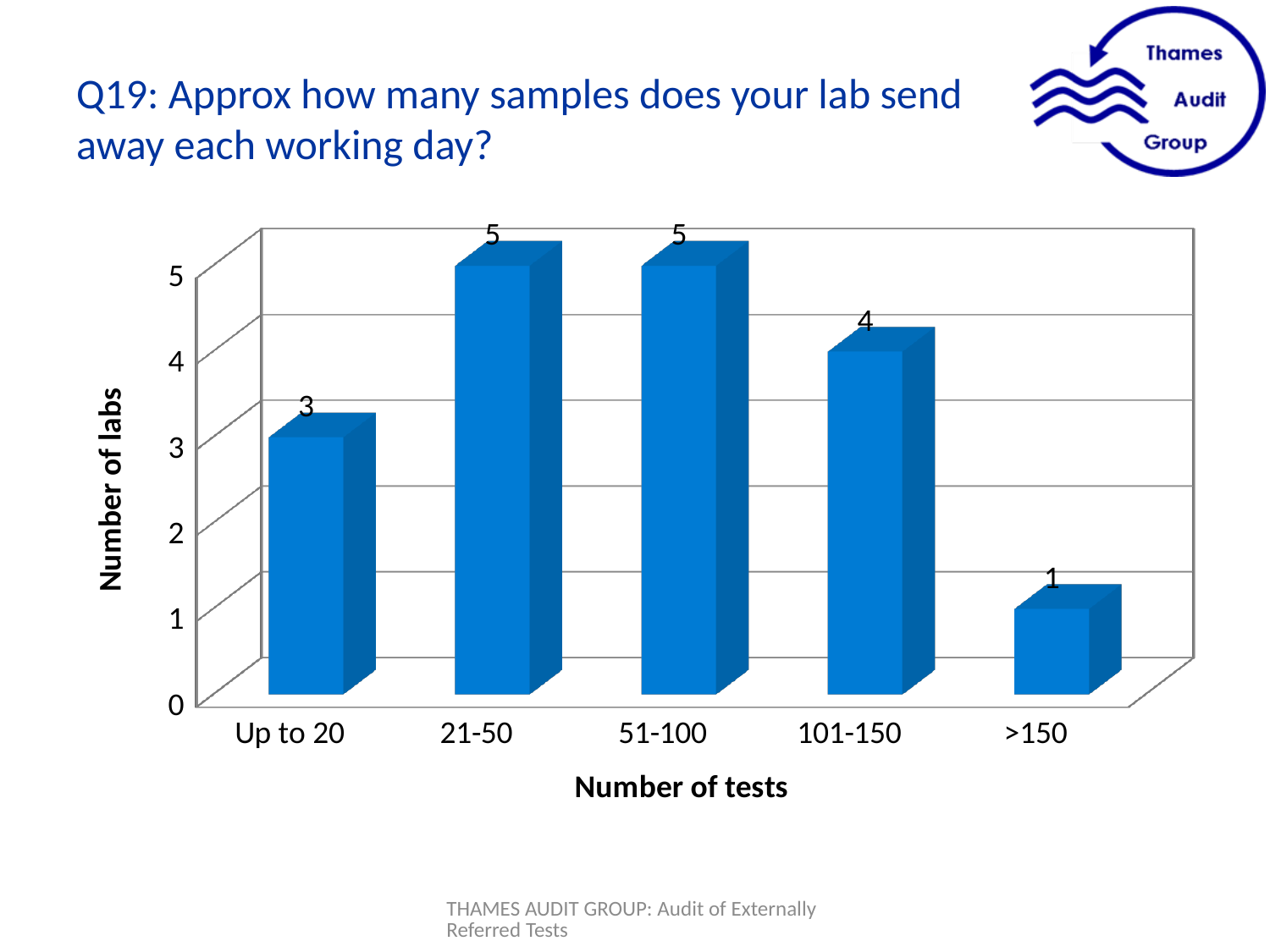
Which category has the lowest number of labs? >150 How many categories are shown on the x axis? 5 What kind of chart is shown on the slide? Bar chart How many labs send up to 20 samples away each working day? 3 What is the total number of labs across all five categories? 18 Which has more labs, Up to 20 or 101-150? 101-150 What is the label of the x axis? Number of tests What is the number of labs for the >150 category? 1 What is the label of the y axis? Number of labs What is the difference in number of labs between the 21-50 and >150 categories? 4 What is the difference in number of labs between 101-150 and Up to 20? 1 What is the number of labs for the 101-150 category? 4